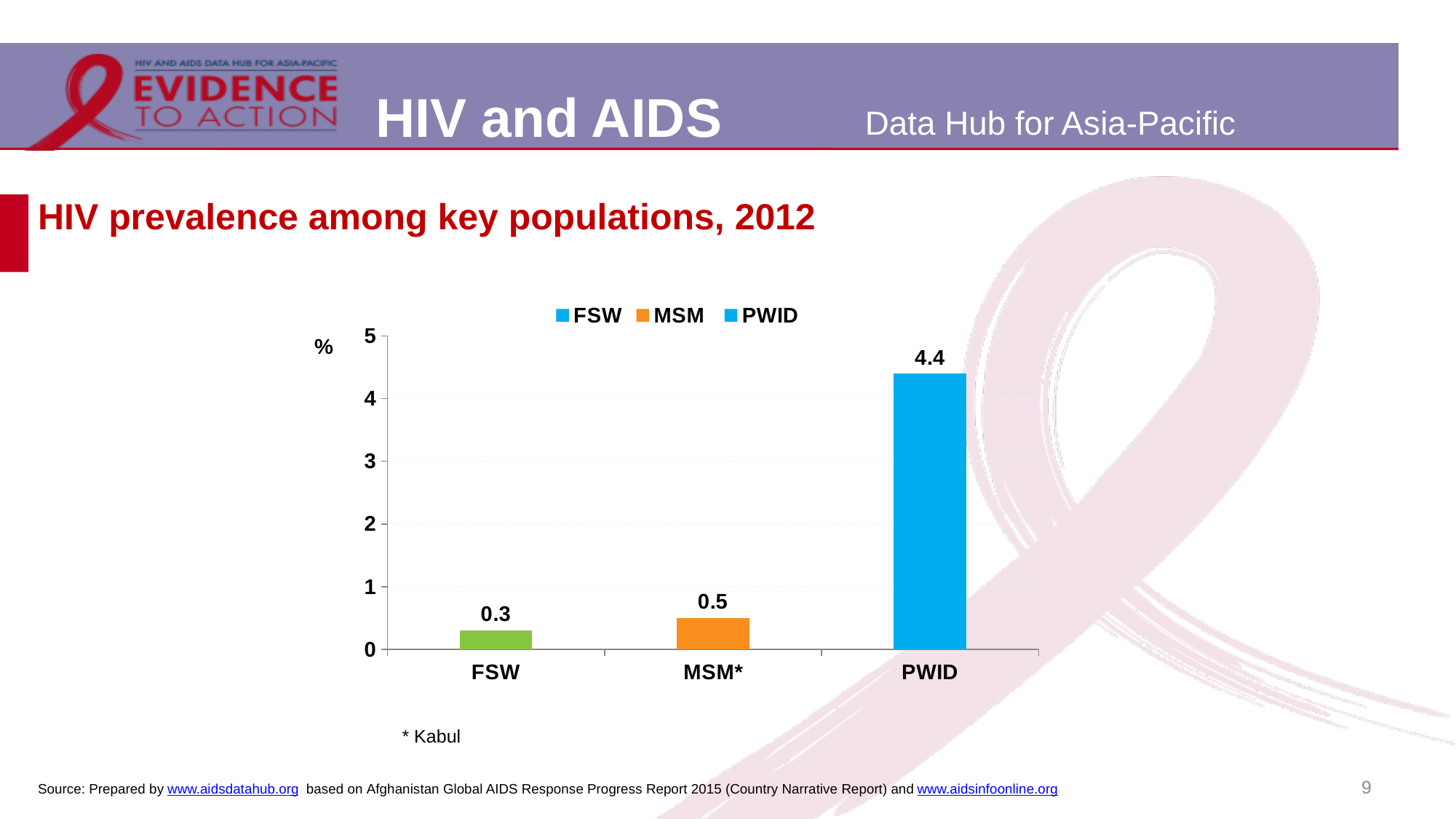
What is the difference between the HIV prevalence for PWID and for MSM*? 3.9 What kind of chart is shown on the slide? bar chart What does the asterisk next to MSM refer to, according to the note below the chart? Kabul What is the HIV prevalence value shown for PWID? 4.4 How many key populations are shown on the chart? 3 What is the difference between the HIV prevalence for MSM* and for FSW? 0.2 Which key population has the lowest HIV prevalence on the chart? FSW What is the HIV prevalence value shown for FSW? 0.3 Is the value for PWID greater or less than 4? greater Which has a higher HIV prevalence, FSW or MSM*? MSM* Which key population has the highest HIV prevalence on the chart? PWID What is the HIV prevalence value shown for MSM*? 0.5